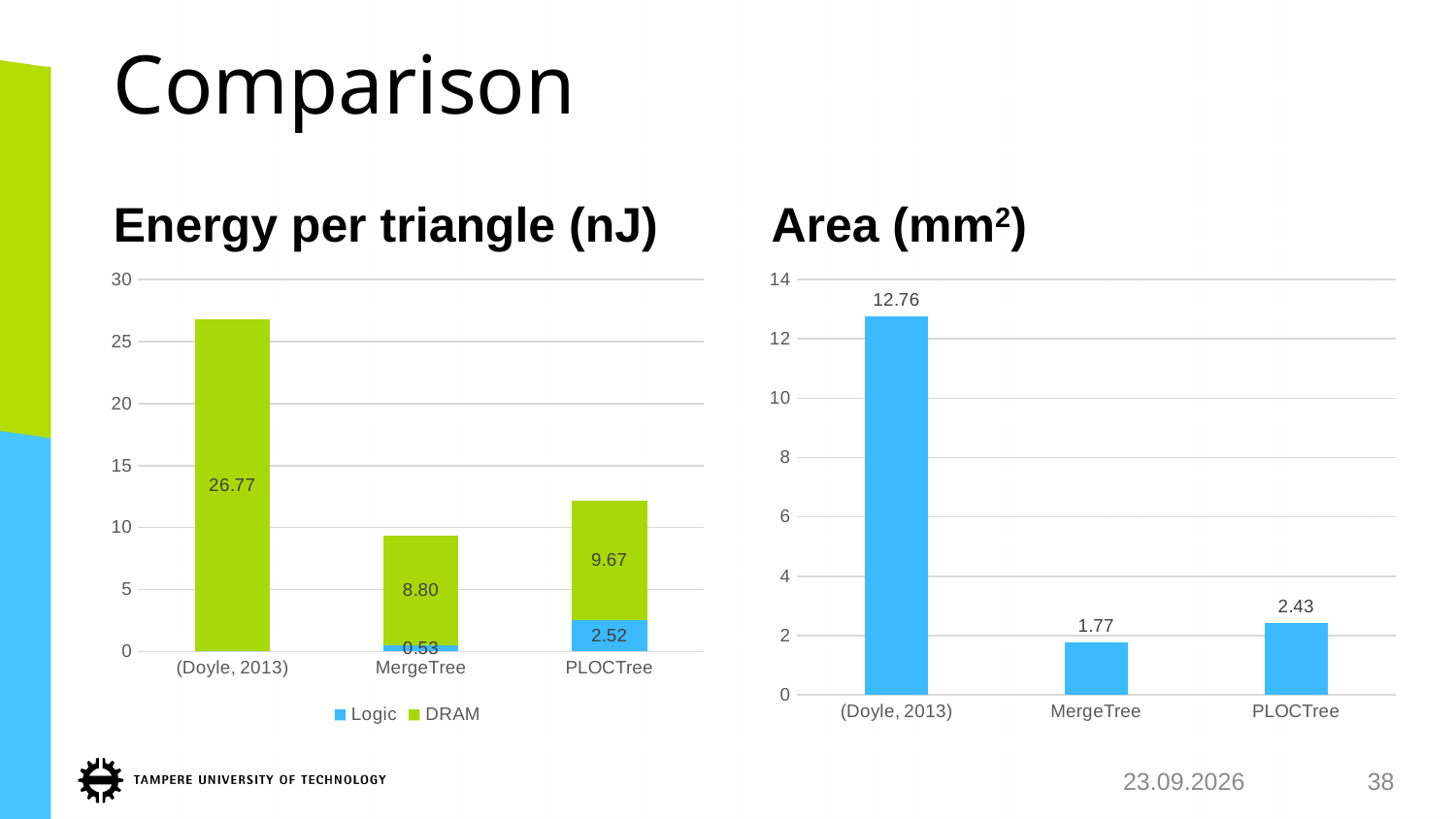
In the Energy per triangle (nJ) chart, what is the difference between the DRAM values for PLOCTree and MergeTree? 0.87 In the Energy per triangle (nJ) chart, what is the DRAM value for MergeTree? 8.80 In the Energy per triangle (nJ) chart, what is the Logic value for PLOCTree? 2.52 In the Energy per triangle (nJ) chart, what is the total of the stacked bar for PLOCTree? 12.19 In the Area (mm²) chart, what is the difference between the values for PLOCTree and MergeTree? 0.66 What kind of chart is the Area (mm²) chart? Bar chart In the Area (mm²) chart, how many categories are shown on the x axis? 3 In the Area (mm²) chart, which category has the lowest value? MergeTree In the Energy per triangle (nJ) chart, what is the total of the stacked bar for MergeTree? 9.33 In the Energy per triangle (nJ) chart, what is the DRAM value for (Doyle, 2013)? 26.77 In the Area (mm²) chart, what is the value for (Doyle, 2013)? 12.76 In the Energy per triangle (nJ) chart, how many series does the legend list? 2